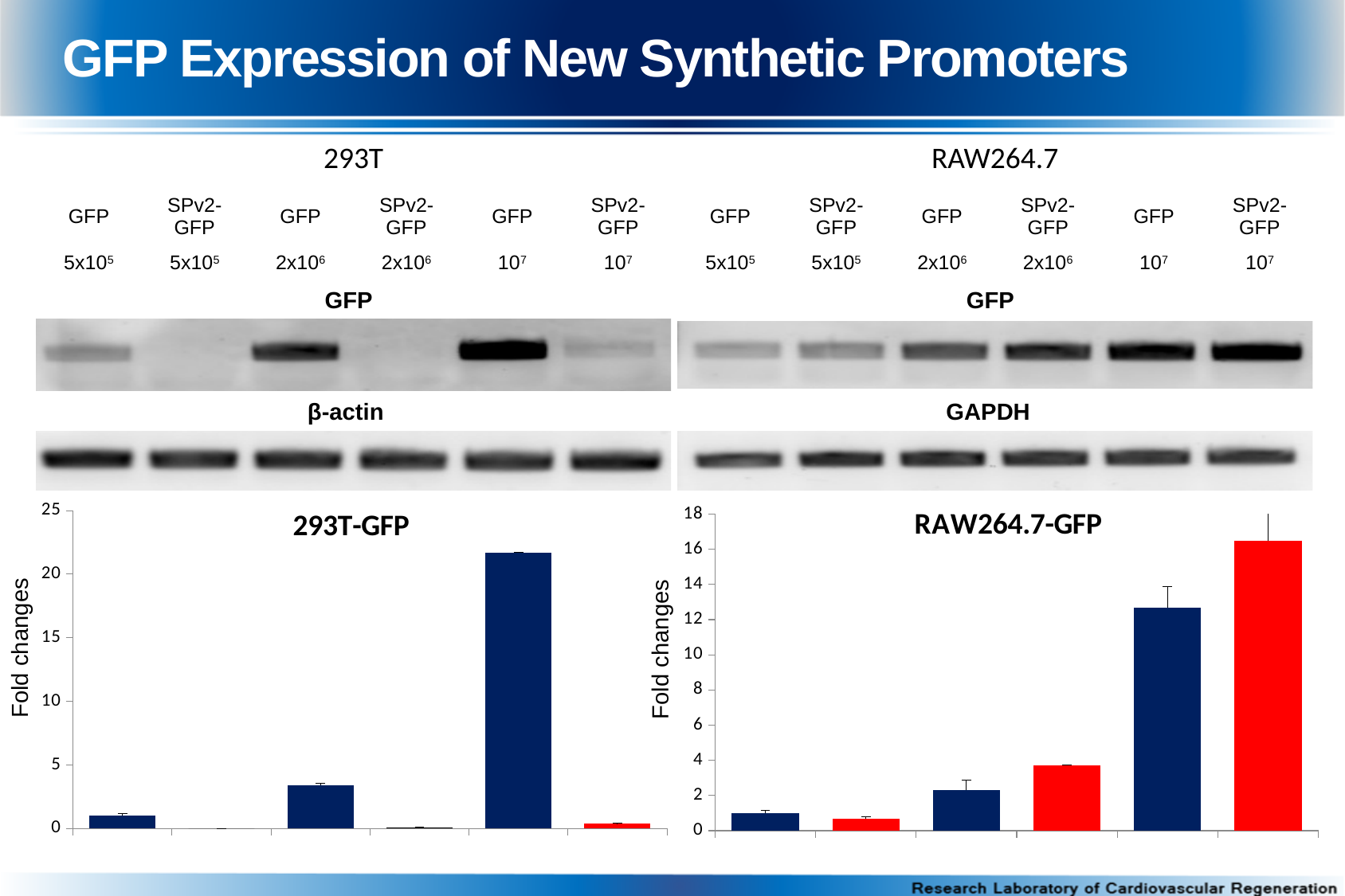
In the 293T-GFP chart, is the value of the third bar greater or less than 5? less In the RAW264.7-GFP chart, is the value of the fifth bar greater or less than 10? greater In the 293T-GFP chart, which bar (by position from the left) is the tallest? the fifth bar In the RAW264.7-GFP chart, which bar (by position from the left) is the tallest? the sixth bar In the RAW264.7-GFP chart, is the value of the sixth bar greater or less than 15? greater How many bars are plotted in the RAW264.7-GFP chart? 6 What kind of chart is the 293T-GFP chart? bar chart What is the highest tick value shown on the y-axis of the RAW264.7-GFP chart? 18 What is the y-axis label of the 293T-GFP chart? Fold changes In the RAW264.7-GFP chart, which is taller, the third bar or the fourth bar? the fourth bar